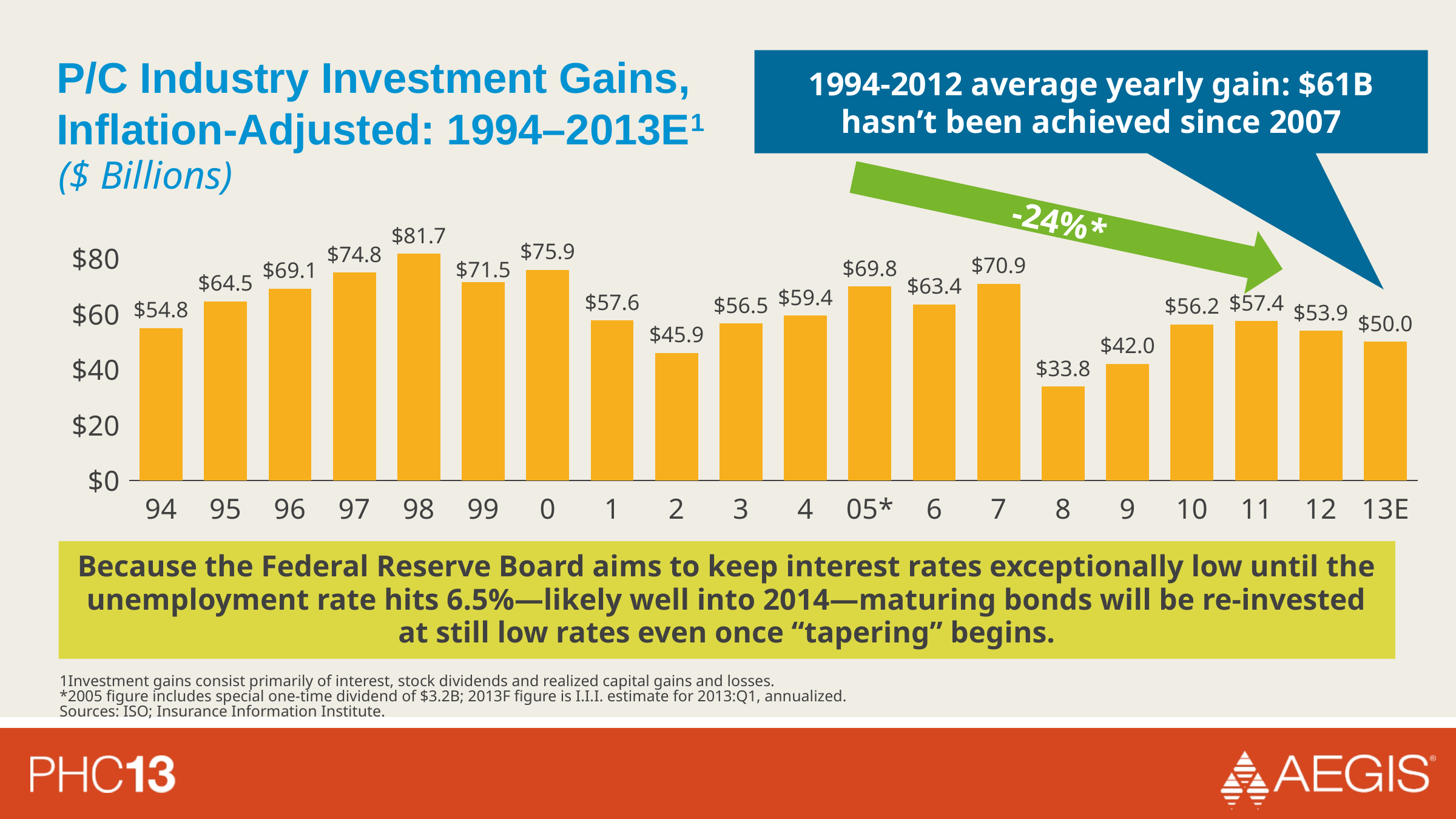
What is the value for 05*? $69.8 What kind of chart is shown? bar chart What is the value for 13E? $50.0 Which is larger, the value for 7 or the value for 9? 7 What is the value for 98? $81.7 Which year has the lowest value? 8 How many bars are shown in the chart? 20 Do the values rise or fall from 10 to 13E? fall Is the value for 2 greater or less than $40? greater Which year has the highest value? 98 What is the title of the chart? P/C Industry Investment Gains, Inflation-Adjusted: 1994–2013E What is the difference between the values for 98 and 8? $47.9